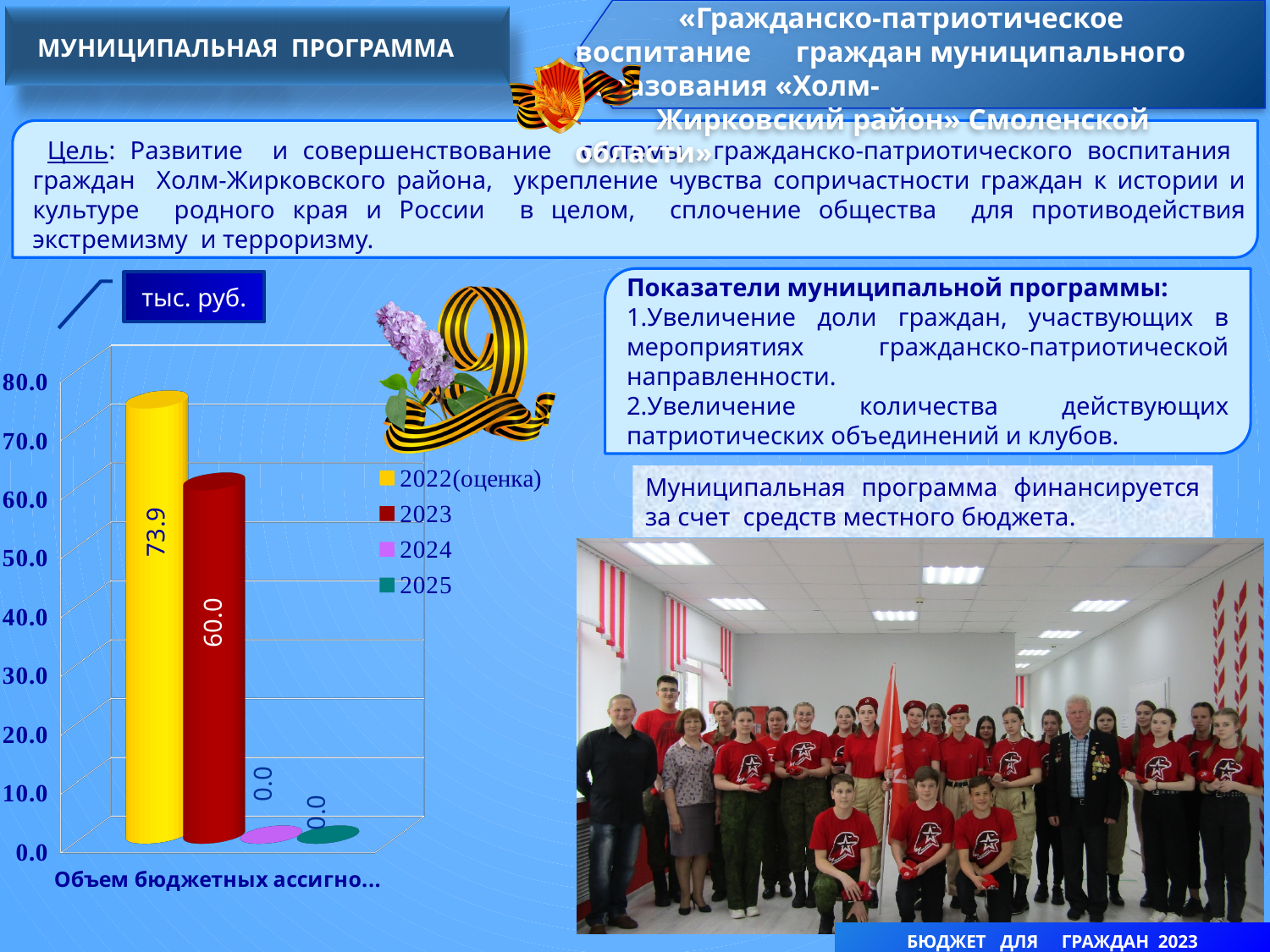
What kind of chart is shown on the slide? bar chart What is the value for 2022(оценка) in the chart? 73.9 What colour is the bar for 2023 in the chart? dark red What is the value for 2025 in the chart? 0.0 Which series has the highest value in the chart? 2022(оценка) What is the difference between the values for 2022(оценка) and 2023? 13.9 Which is larger, the value for 2022(оценка) or the value for 2023? 2022(оценка) What is the value for 2023 in the chart? 60.0 What is the value for 2024 in the chart? 0.0 Is the value for 2023 greater or less than 50.0? greater What unit of measurement is shown above the chart? тыс. руб. How many series does the legend list? 4